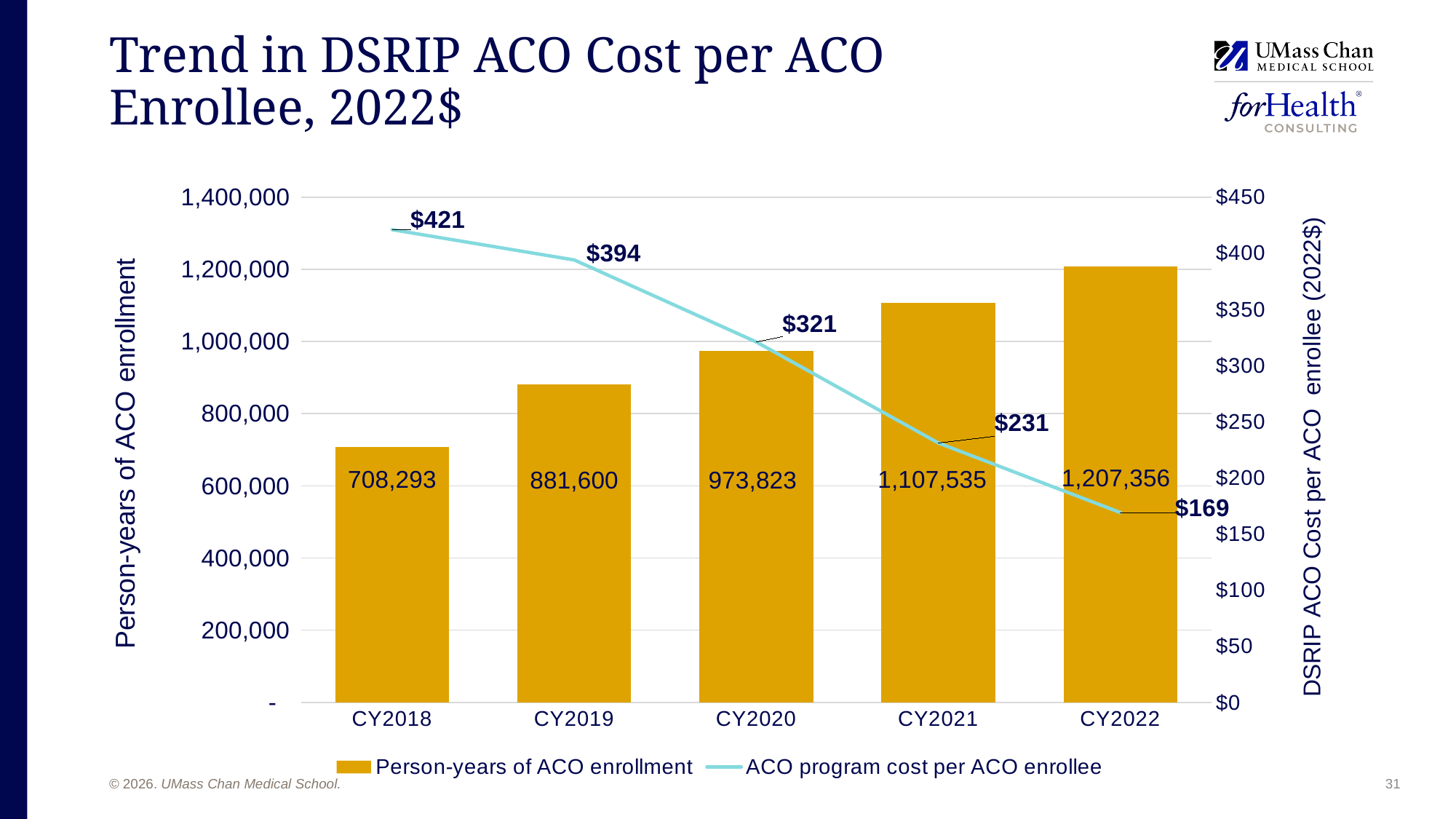
What is the difference in person-years of ACO enrollment between CY2021 and CY2020? 133,712 How many years are shown on the x axis? 5 What is the person-years of ACO enrollment for CY2020? 973,823 Which year has the highest person-years of ACO enrollment? CY2022 Does the ACO program cost per ACO enrollee rise or fall from CY2018 to CY2022? fall Is the person-years of ACO enrollment for CY2019 greater or less than 800,000? greater Which is larger, the ACO program cost per ACO enrollee in CY2020 or in CY2021? CY2020 How many series does the legend list? 2 Which year has the lowest ACO program cost per ACO enrollee? CY2022 What is the ACO program cost per ACO enrollee for CY2019? $394 What is the label of the right-hand vertical axis? DSRIP ACO Cost per ACO enrollee (2022$) What is the difference in ACO program cost per ACO enrollee between CY2018 and CY2022? $252